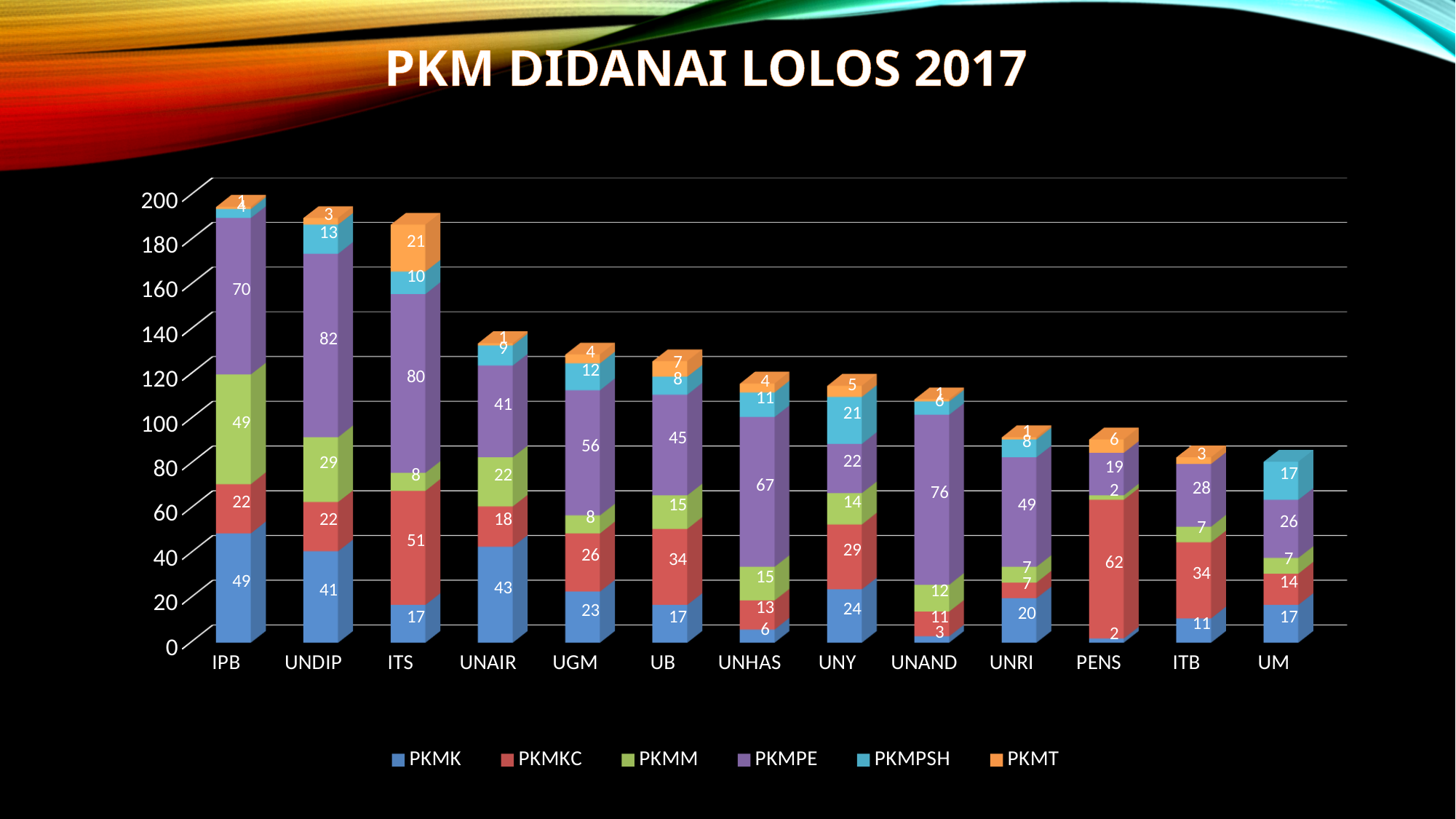
What is the difference between the PKMKC value for ITS and the PKMKC value for UGM? 25 Which university has the highest PKMK value? IPB What is the PKMPE value for UNDIP? 82 What is the PKMKC value for PENS? 62 What is the PKMT value for ITS? 21 Which university has the highest PKMKC value? PENS What is the total of the stacked bar for UGM? 129 How many series does the legend list? 6 What kind of chart is shown on the slide? Stacked bar chart How many universities are shown on the x axis? 13 Is the total of the stacked bar for UNRI greater or less than 100? less Which is larger, the PKMPE value for UNDIP or for UNHAS? UNDIP